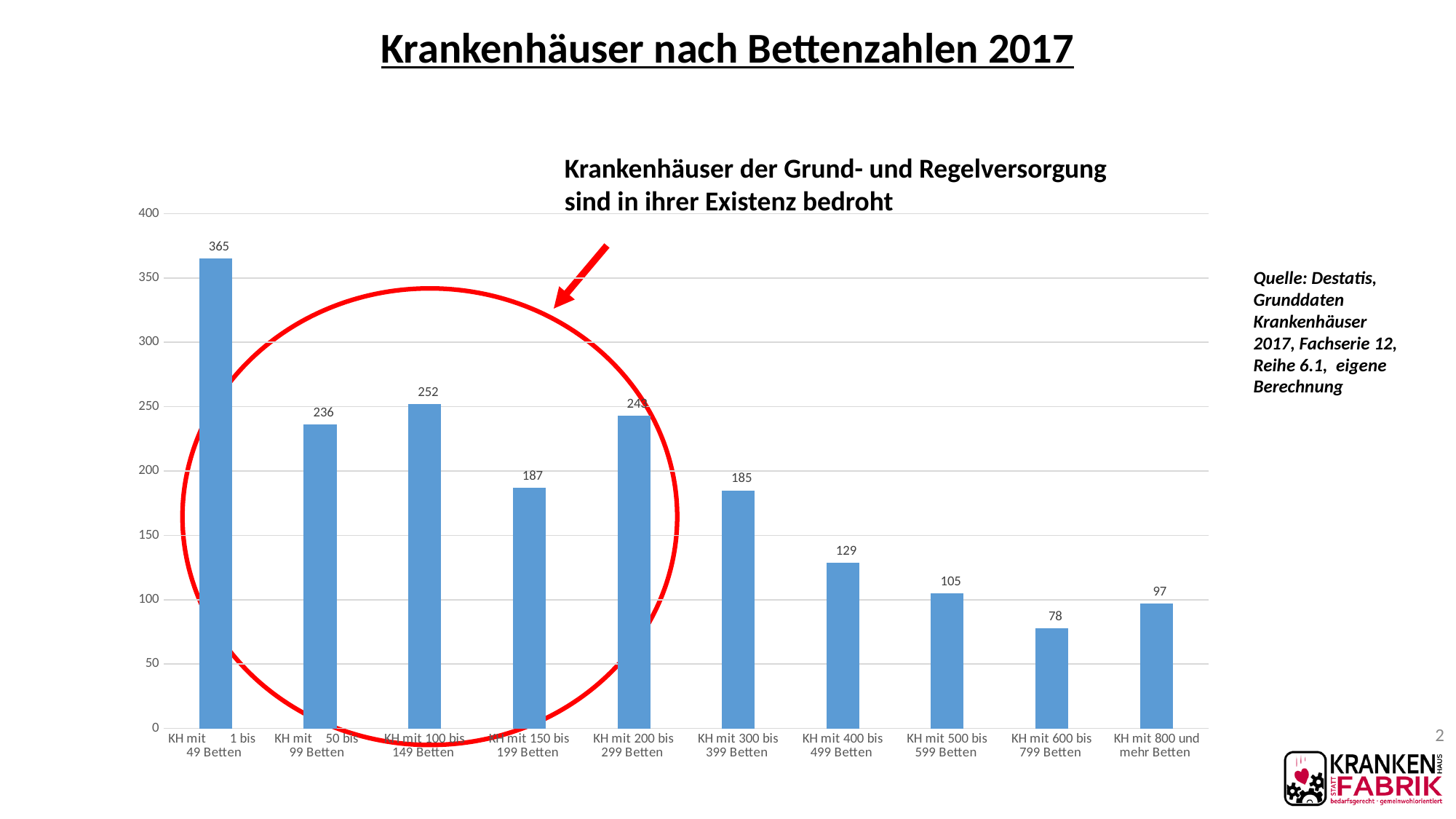
What is the value for 'KH mit 600 bis 799 Betten'? 78 Which category has the highest value? KH mit 1 bis 49 Betten Which is larger: the value for 'KH mit 400 bis 499 Betten' or 'KH mit 500 bis 599 Betten'? KH mit 400 bis 499 Betten What is the value for 'KH mit 100 bis 149 Betten'? 252 What type of chart is shown on the slide? bar chart What is the value for 'KH mit 1 bis 49 Betten'? 365 What is the value for 'KH mit 800 und mehr Betten'? 97 What is the difference between the values for 'KH mit 1 bis 49 Betten' and 'KH mit 50 bis 99 Betten'? 129 What is the title of the slide's chart? Krankenhäuser nach Bettenzahlen 2017 How many bed-size categories are plotted in the chart? 10 Which category has the lowest value? KH mit 600 bis 799 Betten Is the value for 'KH mit 300 bis 399 Betten' greater or less than 200? less